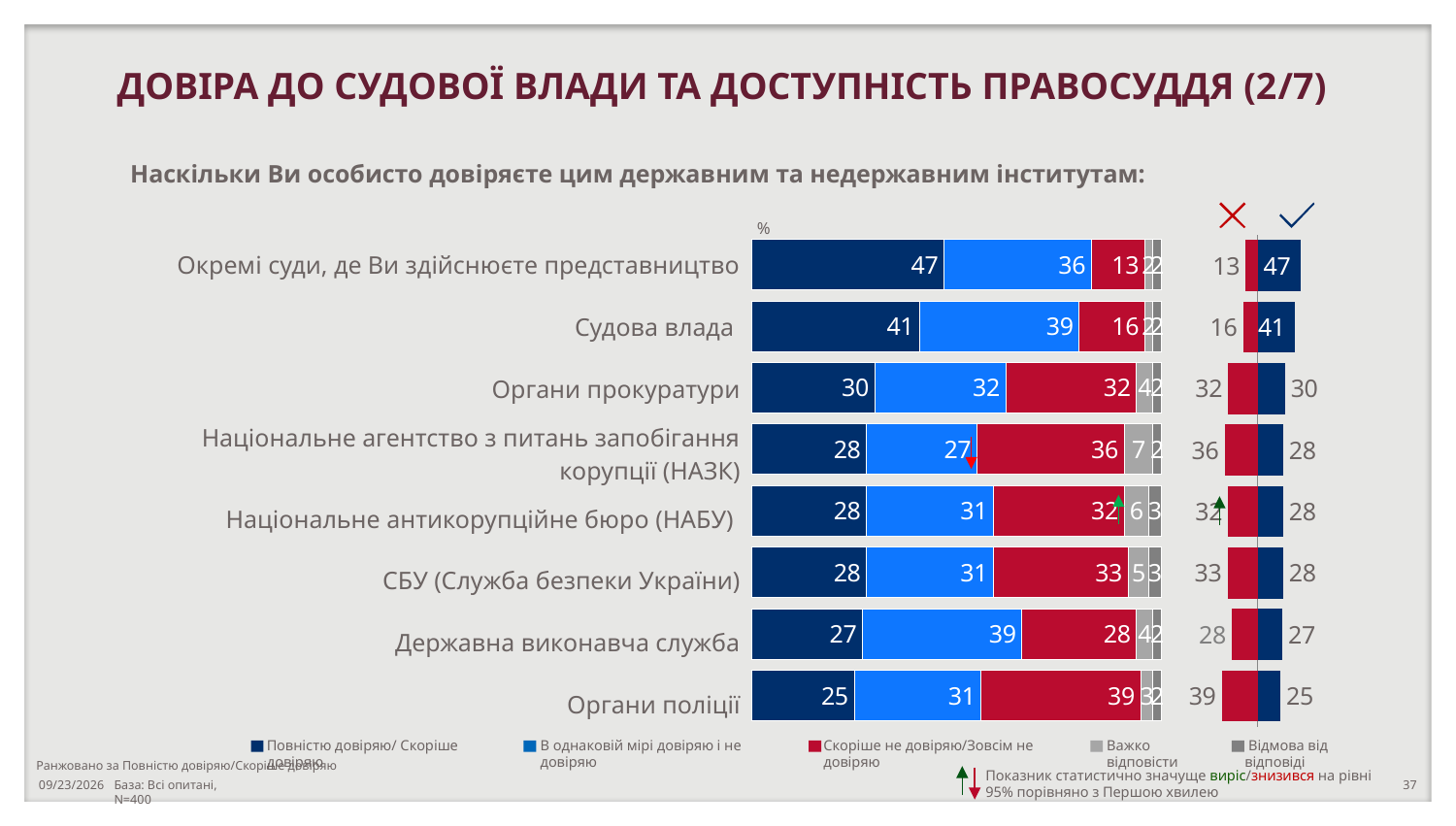
What is the total of all segments in the bar for Судова влада? 100 Which institution has the highest 'Повністю довіряю/ Скоріше довіряю' value? Окремі суди, де Ви здійснюєте представництво How many institutions are listed in the chart? 8 How many series does the legend of the stacked bar chart list? 5 Which has a larger 'Скоріше не довіряю/Зовсім не довіряю' value: Державна виконавча служба or СБУ (Служба безпеки України)? СБУ (Служба безпеки України) What is the 'В однаковій мірі довіряю і не довіряю' value for Державна виконавча служба? 39 What type of chart is used to show trust in the institutions? Stacked bar chart What is the difference between the 'Повністю довіряю/ Скоріше довіряю' values for Судова влада and Органи прокуратури? 11 Which institution has the lowest 'Повністю довіряю/ Скоріше довіряю' value? Органи поліції What is the 'Важко відповісти' value for Національне агентство з питань запобігання корупції (НАЗК)? 7 What is the value of the 'Скоріше не довіряю/Зовсім не довіряю' segment for Органи поліції? 39 What percentage of respondents fully or rather trust (Повністю довіряю/ Скоріше довіряю) the individual courts where they represent clients (Окремі суди, де Ви здійснюєте представництво)? 47